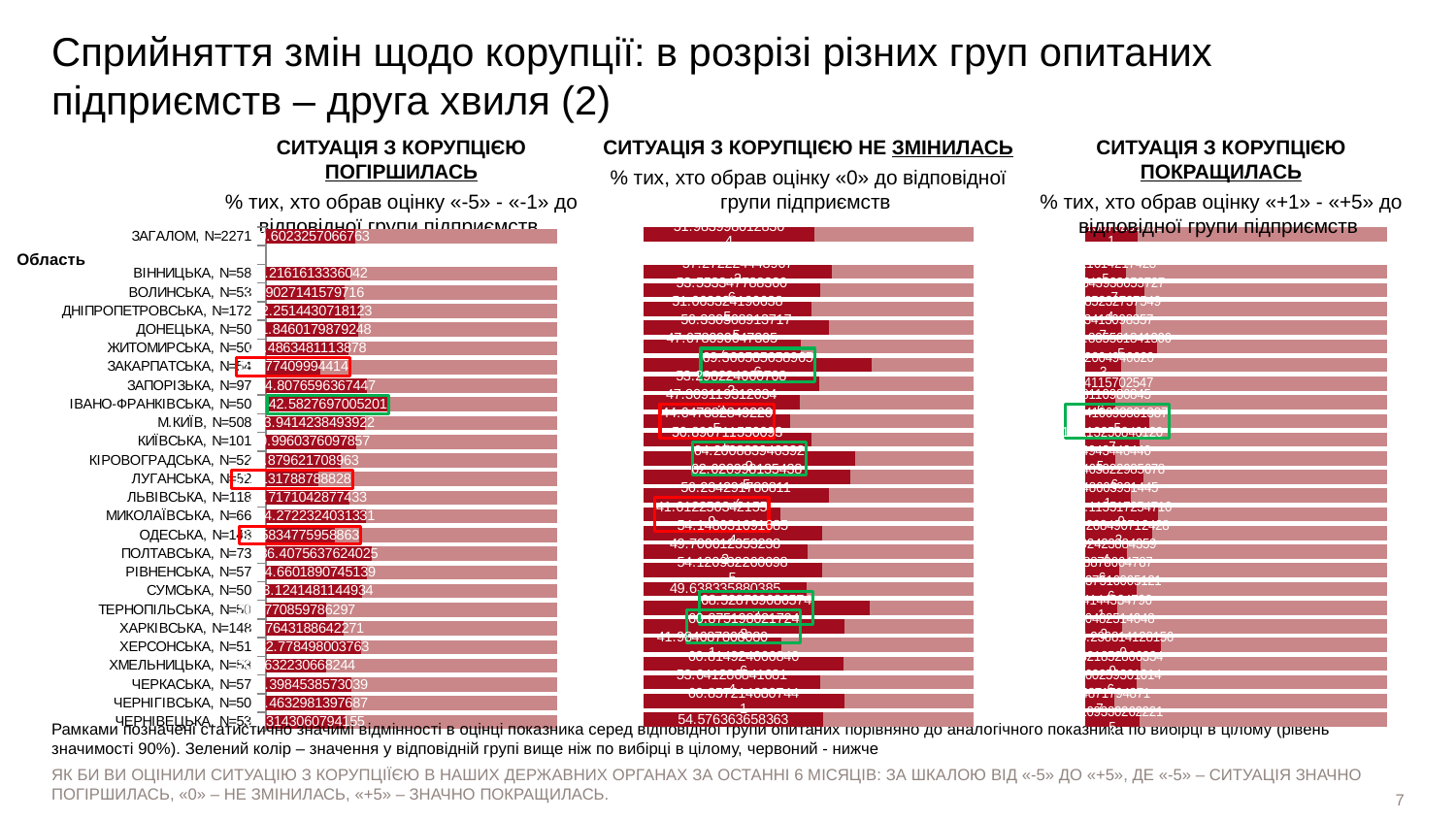
What kind of chart is the right chart titled "СИТУАЦІЯ З КОРУПЦІЄЮ ПОКРАЩИЛАСЬ"? bar chart What is the title of the middle chart on the slide? СИТУАЦІЯ З КОРУПЦІЄЮ НЕ ЗМІНИЛАСЬ What kind of chart is the left chart titled "СИТУАЦІЯ З КОРУПЦІЄЮ ПОГІРШИЛАСЬ"? bar chart In the left chart titled "СИТУАЦІЯ З КОРУПЦІЄЮ ПОГІРШИЛАСЬ", how many categories (rows) are plotted, including ЗАГАЛОМ? 26 What kind of chart is the middle chart titled "СИТУАЦІЯ З КОРУПЦІЄЮ НЕ ЗМІНИЛАСЬ"? bar chart How many charts are shown on the slide? 3 In the middle chart titled "СИТУАЦІЯ З КОРУПЦІЄЮ НЕ ЗМІНИЛАСЬ", which has the larger value: ЗАКАРПАТСЬКА or ІВАНО-ФРАНКІВСЬКА? ЗАКАРПАТСЬКА